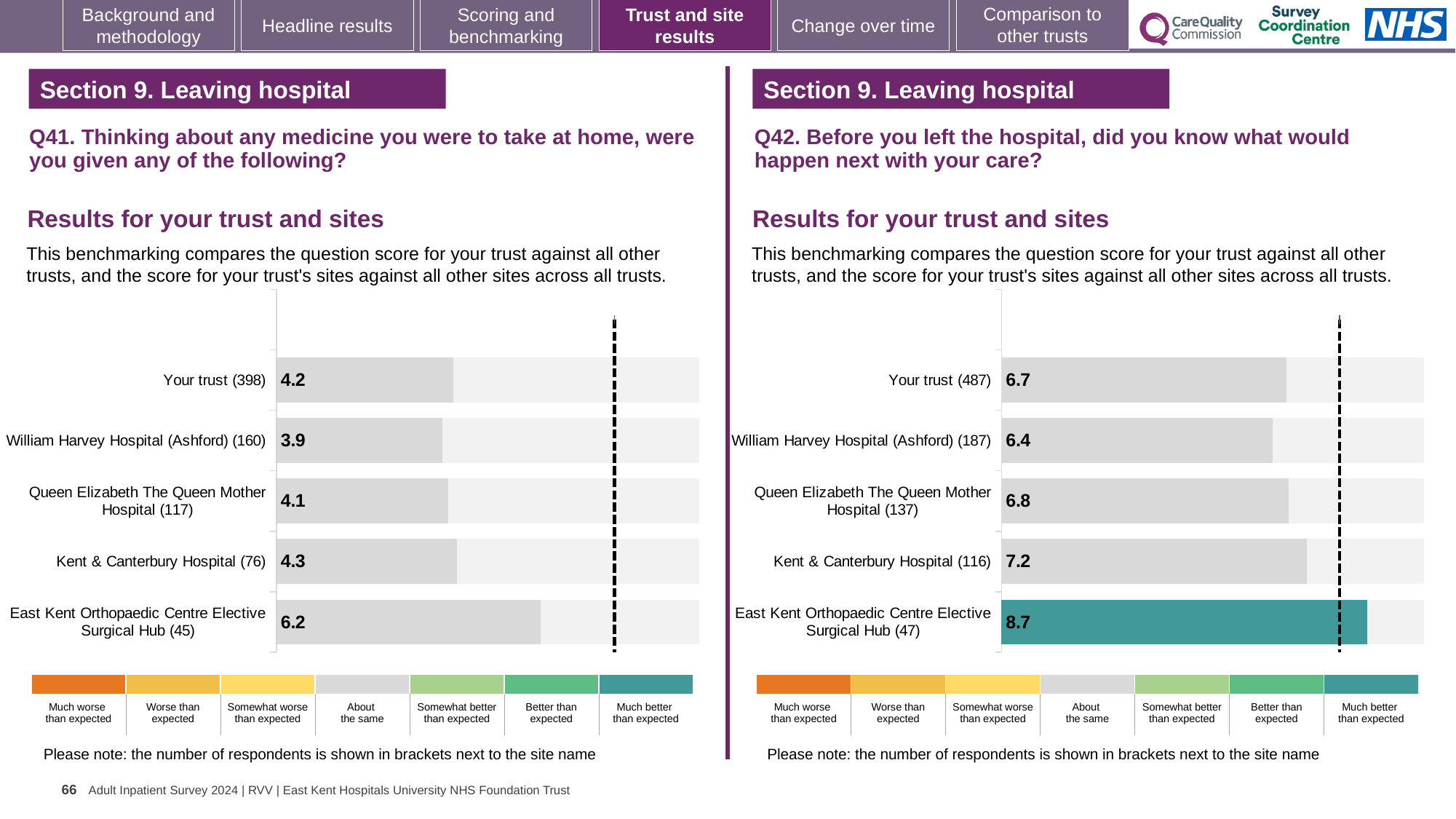
In the Q42 chart on the right, which site has the highest score? East Kent Orthopaedic Centre Elective Surgical Hub (47) In the Q41 chart on the left, which site has the highest score? East Kent Orthopaedic Centre Elective Surgical Hub (45) In the Q42 chart on the right, which site's bar is coloured teal, indicating 'Much better than expected'? East Kent Orthopaedic Centre Elective Surgical Hub (47) In the Q41 chart on the left, which site has the lowest score? William Harvey Hospital (Ashford) (160) In the Q42 chart on the right, which is larger: the score for Your trust or the score for Queen Elizabeth The Queen Mother Hospital? Queen Elizabeth The Queen Mother Hospital In the Q42 chart on the right, what is the score for William Harvey Hospital (Ashford) (187)? 6.4 In the Q41 chart on the left, what is the score for Your trust (398)? 4.2 In the Q41 chart on the left, how many bars are plotted? 5 In the Q41 chart on the left, what is the difference between the scores for East Kent Orthopaedic Centre Elective Surgical Hub and Kent & Canterbury Hospital? 1.9 In the Q42 chart on the right, what is the difference between the scores for East Kent Orthopaedic Centre Elective Surgical Hub and Your trust? 2.0 In the Q42 chart on the right, what is the score for Kent & Canterbury Hospital (116)? 7.2 What type of chart is used on the slide to show the trust and site results? Bar chart